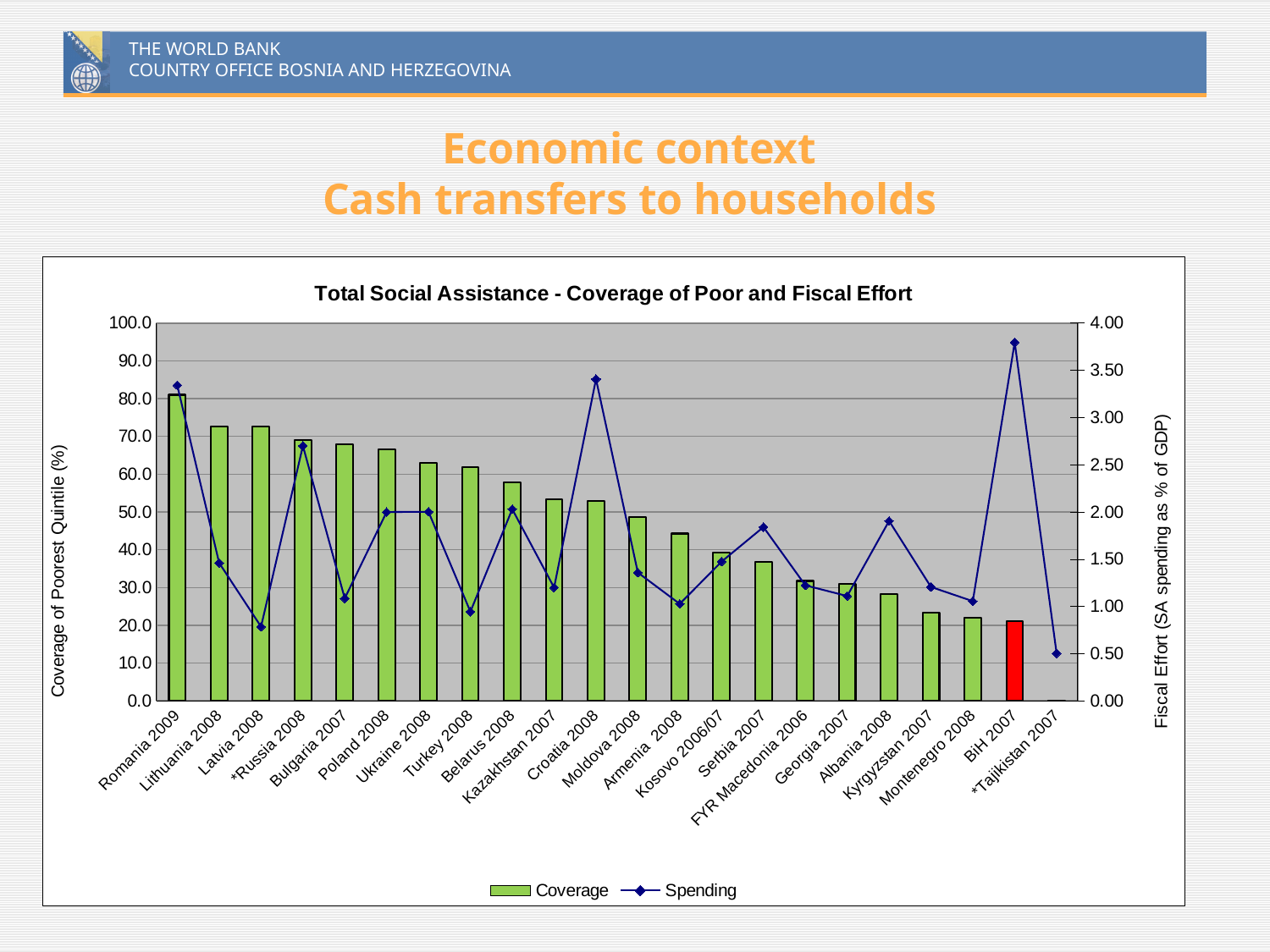
Which country has the lowest Spending value? *Tajikistan 2007 Which country has the lowest Coverage bar? *Tajikistan 2007 Which has the larger Coverage value, Romania 2009 or Serbia 2007? Romania 2009 Which country has the highest Spending value? BiH 2007 What kind of chart is shown on the slide? Combined bar and line chart Is the Coverage value for BiH 2007 greater or less than 30.0? less Do the Coverage bars generally rise or fall from left to right along the x axis? fall How many series does the legend list? 2 How many countries are shown on the x axis? 22 Is the Coverage value for Poland 2008 greater or less than 60.0? greater Which country has the highest Coverage bar? Romania 2009 Is the Spending value for Croatia 2008 greater or less than 3.00? greater